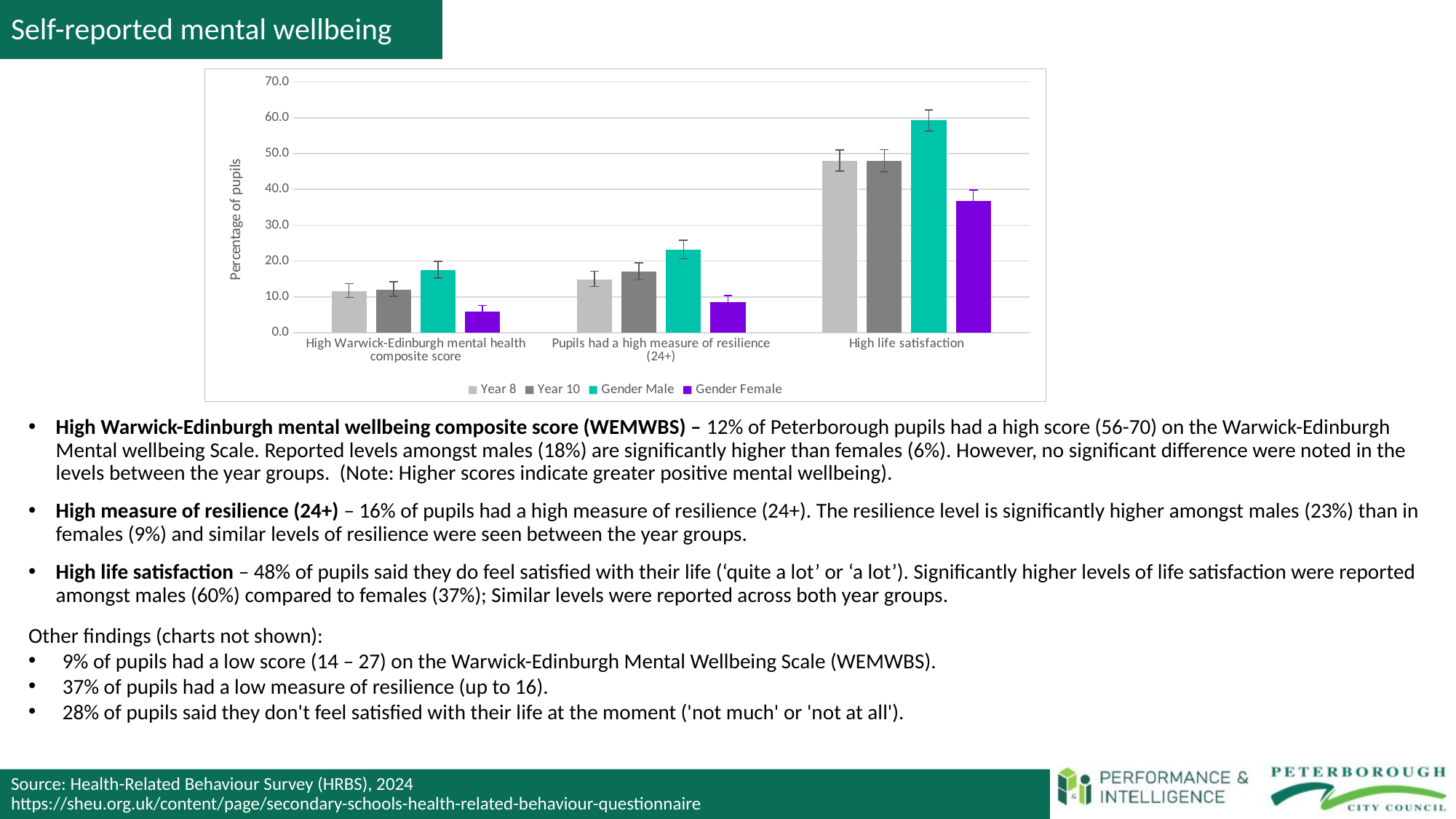
What is the label on the chart's vertical axis? Percentage of pupils Is the Year 8 value for High Warwick-Edinburgh mental health composite score greater or less than 20.0? less How many series does the chart's legend list? 4 For Pupils had a high measure of resilience (24+), which is larger: the Gender Male bar or the Gender Female bar? Gender Male For High Warwick-Edinburgh mental health composite score, which is larger: the Year 8 bar or the Gender Male bar? Gender Male Which series has the highest bar for High life satisfaction? Gender Male Is the Gender Female value for High life satisfaction greater or less than 30.0? greater For which category is the Gender Male bar the tallest? High life satisfaction How many categories are shown on the x axis of the chart? 3 Which series has the lowest bar for High Warwick-Edinburgh mental health composite score? Gender Female What kind of chart is shown on the slide? Bar chart Is the Gender Male value for High life satisfaction greater or less than 50.0? greater